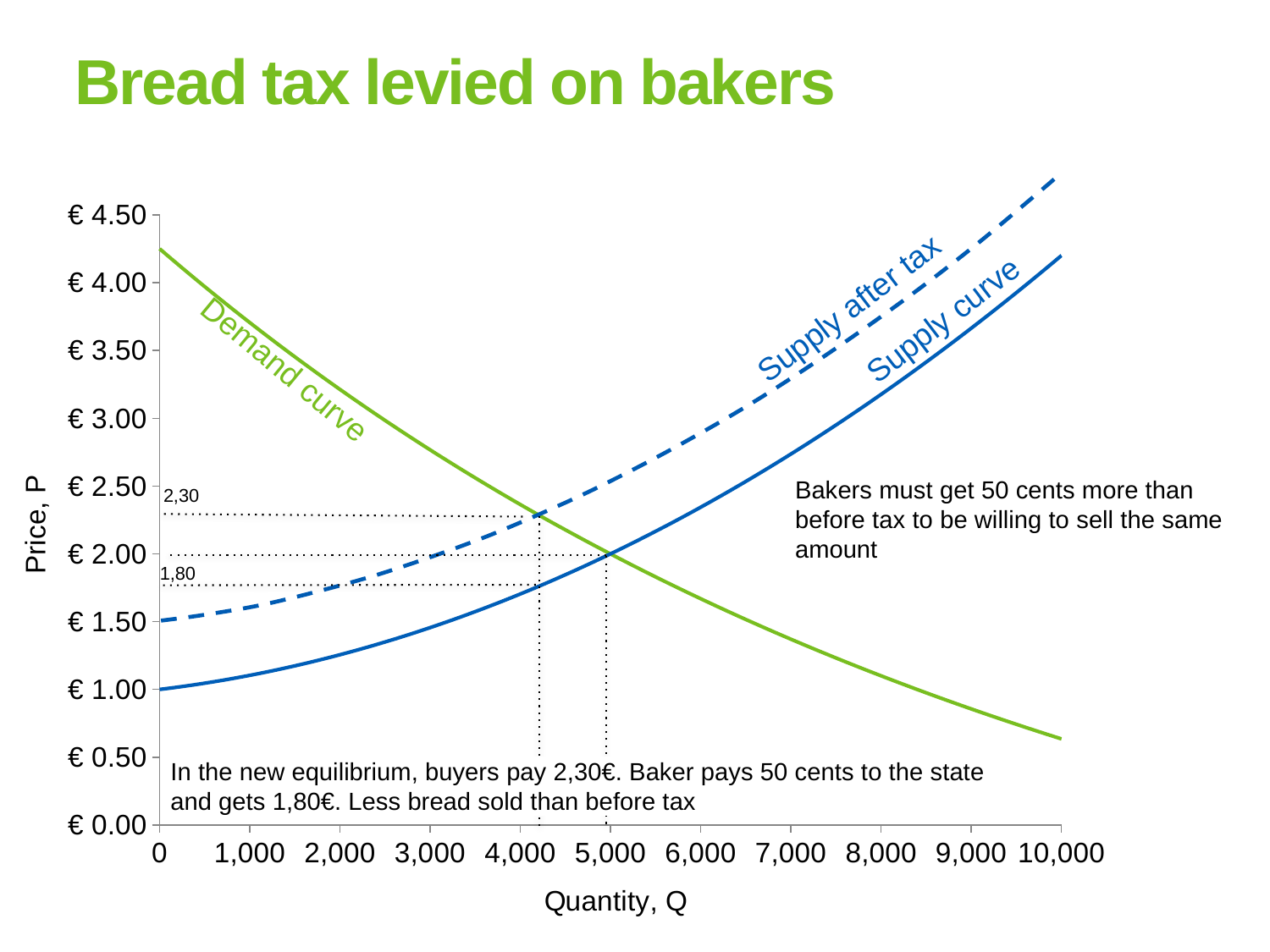
Does the supply curve rise or fall as quantity increases? rise What is the difference between the price buyers pay (2,30) and the price the baker gets (1,80) in the new equilibrium? 50 cents According to the chart, what price does the baker get after paying the tax in the new equilibrium? 1,80 At a quantity of 2,000, which curve is higher: the supply after tax or the supply curve? Supply after tax Is the quantity sold in the new equilibrium after the tax greater or less than 5,000? less What kind of chart is shown on the slide? line chart According to the chart, what price do buyers pay in the new equilibrium after the tax? 2,30 How many curves are plotted on the chart? 3 Does the demand curve rise or fall as quantity increases? fall Is the value of the demand curve at a quantity of 10,000 greater or less than € 1.00? less What is the label of the x axis of the chart? Quantity, Q Which curve on the chart is drawn as a dashed line? Supply after tax